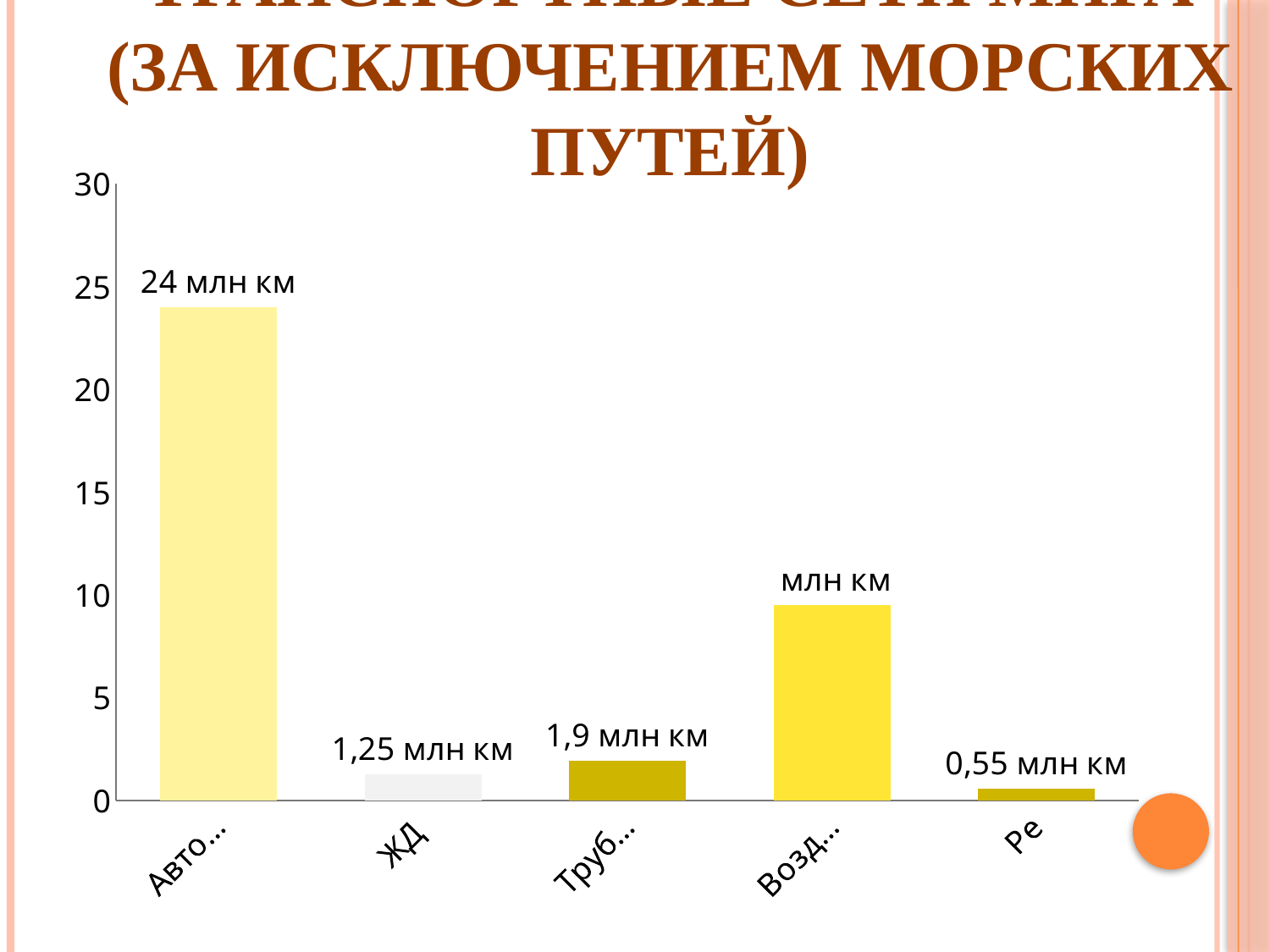
What is the difference between the values for "Труб…" and ЖД? 0,65 млн км How many bars are plotted in the chart? 5 Is the value for the bar labelled "Возд…" greater or less than 5? greater What value is shown for the ЖД bar? 1,25 млн км What value is shown for the bar labelled "Труб…"? 1,9 млн км What is the difference between the values for "Авто…" and ЖД? 22,75 млн км What kind of chart is shown on the slide? bar chart Which category has the highest bar? Авто… What value is shown for the first bar on the left (labelled "Авто…")? 24 млн км Which category has the lowest bar? Ре What value is shown for the last bar on the right (labelled "Ре")? 0,55 млн км Which is larger, the value for ЖД or the value for "Труб…"? Труб…